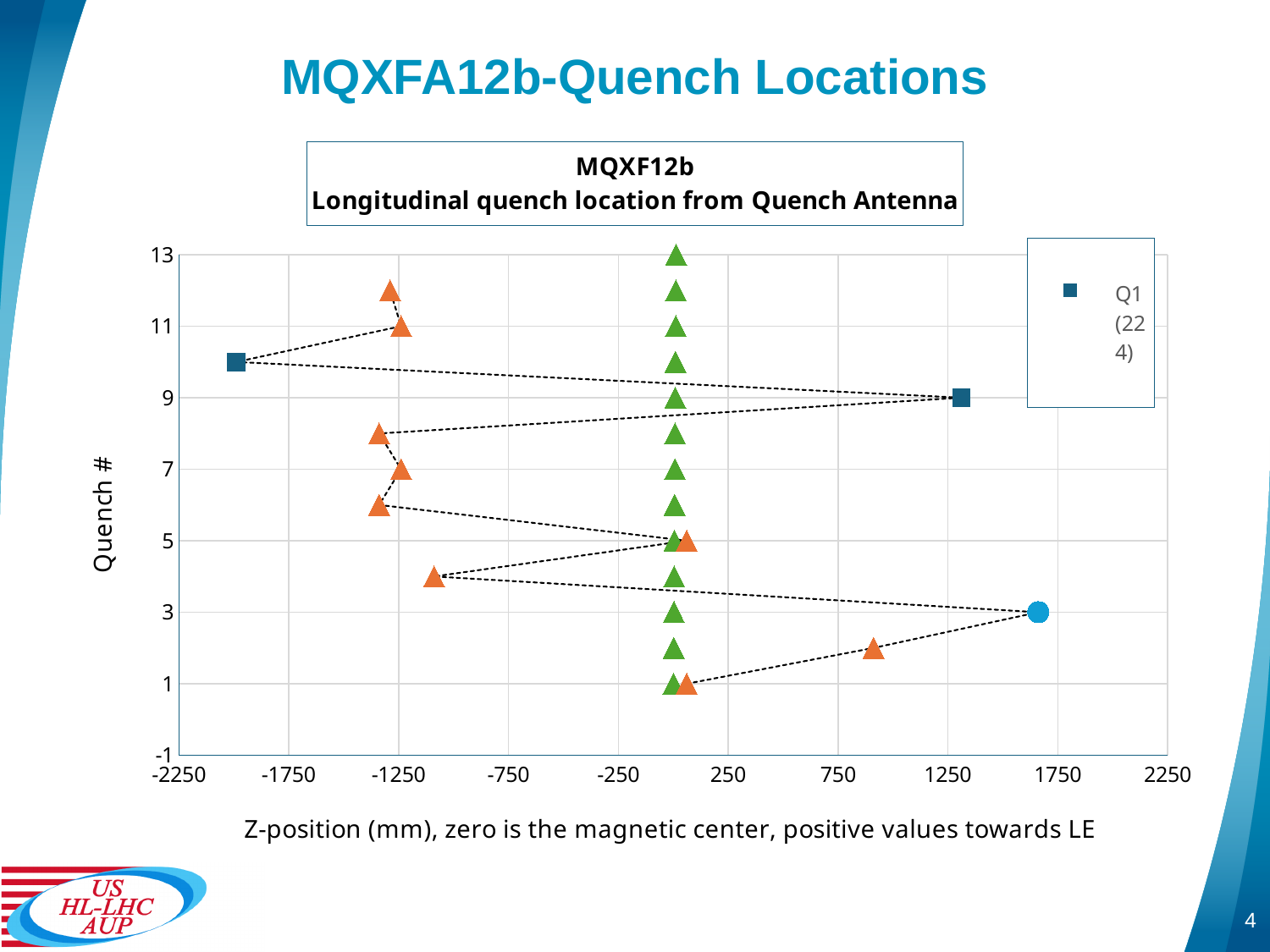
Is the Z-position of the orange triangle at quench 2 greater or less than 750? greater Is the Z-position of the orange triangle at quench 4 greater or less than -750? less Which quench number has the marker with the most negative Z-position? 10 Is the Z-position of the blue square marker at quench 10 greater or less than -1750? less What is the title of the chart? MQXF12b Longitudinal quench location from Quench Antenna Which quench number has the marker with the largest positive Z-position? 3 Which has the larger Z-position: the marker at quench 3 or the blue square at quench 9? quench 3 What kind of chart is shown on the slide? scatter chart What is the label of the vertical axis? Quench #